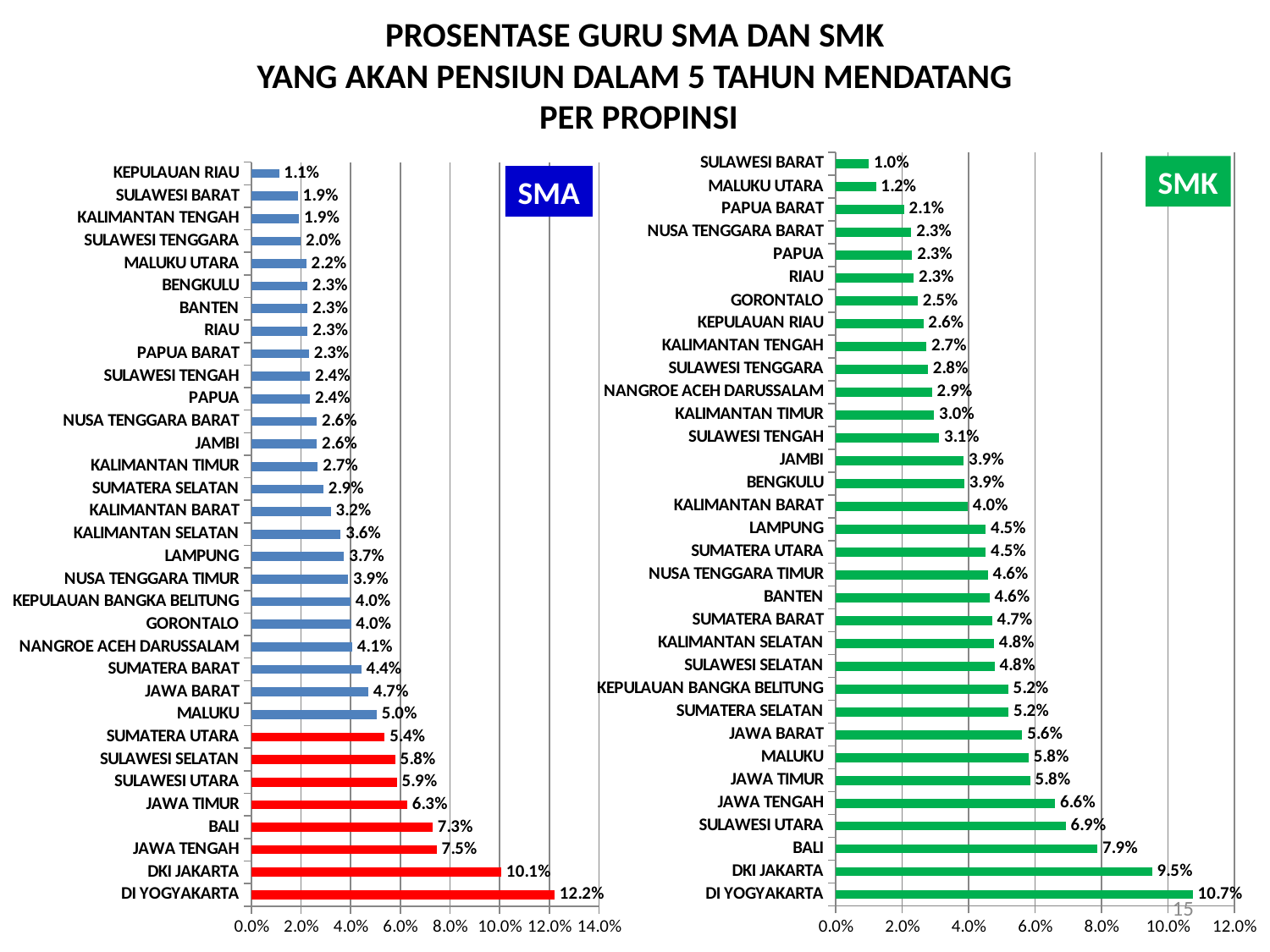
In the SMA chart, what colour are the bars for the provinces with the highest values, such as DI YOGYAKARTA and DKI JAKARTA? red Which is larger: the SMA value for JAWA TENGAH or the SMK value for JAWA TENGAH? SMA (7.5%) What type of chart is the SMA chart? bar chart In the SMA chart, what is the value for DI YOGYAKARTA? 12.2% In the SMK chart, what is the difference between DKI JAKARTA and SULAWESI UTARA? 2.6% In the SMK chart, which province has the highest value? DI YOGYAKARTA In the SMK chart, what is the value for BALI? 7.9% In the SMA chart, what is the difference between DI YOGYAKARTA and DKI JAKARTA? 2.1% In the SMA chart, is the value for BALI greater or less than 6.0%? greater In the SMK chart, which province has the lowest value? SULAWESI BARAT How many provinces are listed in the SMK chart? 33 In the SMA chart, which province has the lowest value? KEPULAUAN RIAU